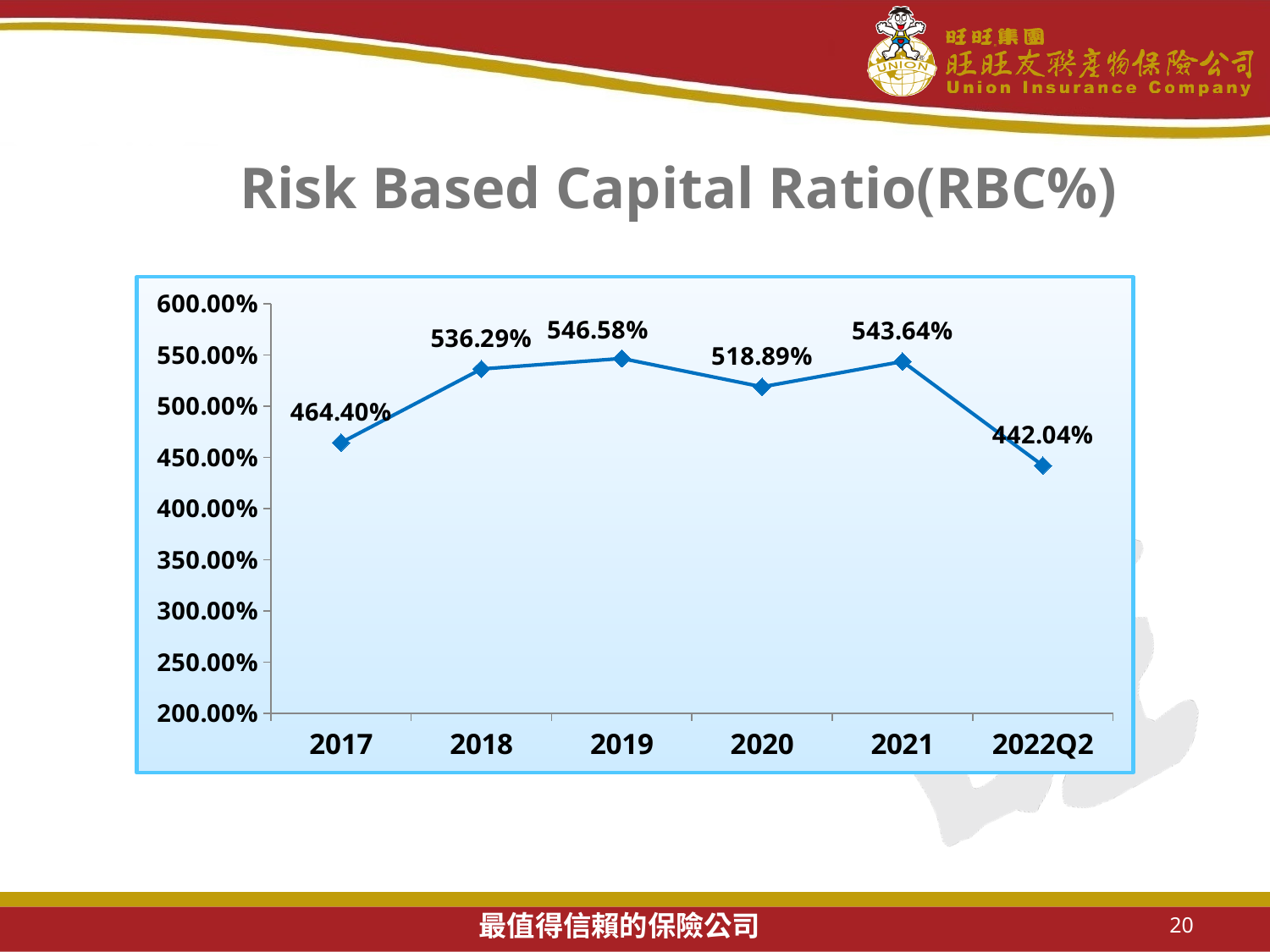
Did the Risk Based Capital Ratio rise or fall from 2021 to 2022Q2? Fall Is the Risk Based Capital Ratio for 2017 greater or less than 500.00%? less Which period has the lowest Risk Based Capital Ratio? 2022Q2 What is the Risk Based Capital Ratio for 2022Q2? 442.04% By how many percentage points did the Risk Based Capital Ratio change from 2018 to 2019? 10.29 percentage points What kind of chart is shown on the slide? Line chart Which is larger, the Risk Based Capital Ratio in 2018 or in 2020? 2018 What is the difference between the Risk Based Capital Ratio in 2021 and in 2022Q2? 101.60 percentage points What is the Risk Based Capital Ratio for 2017? 464.40% What is the Risk Based Capital Ratio for 2020? 518.89% Which period has the highest Risk Based Capital Ratio? 2019 How many periods are plotted on the chart? 6